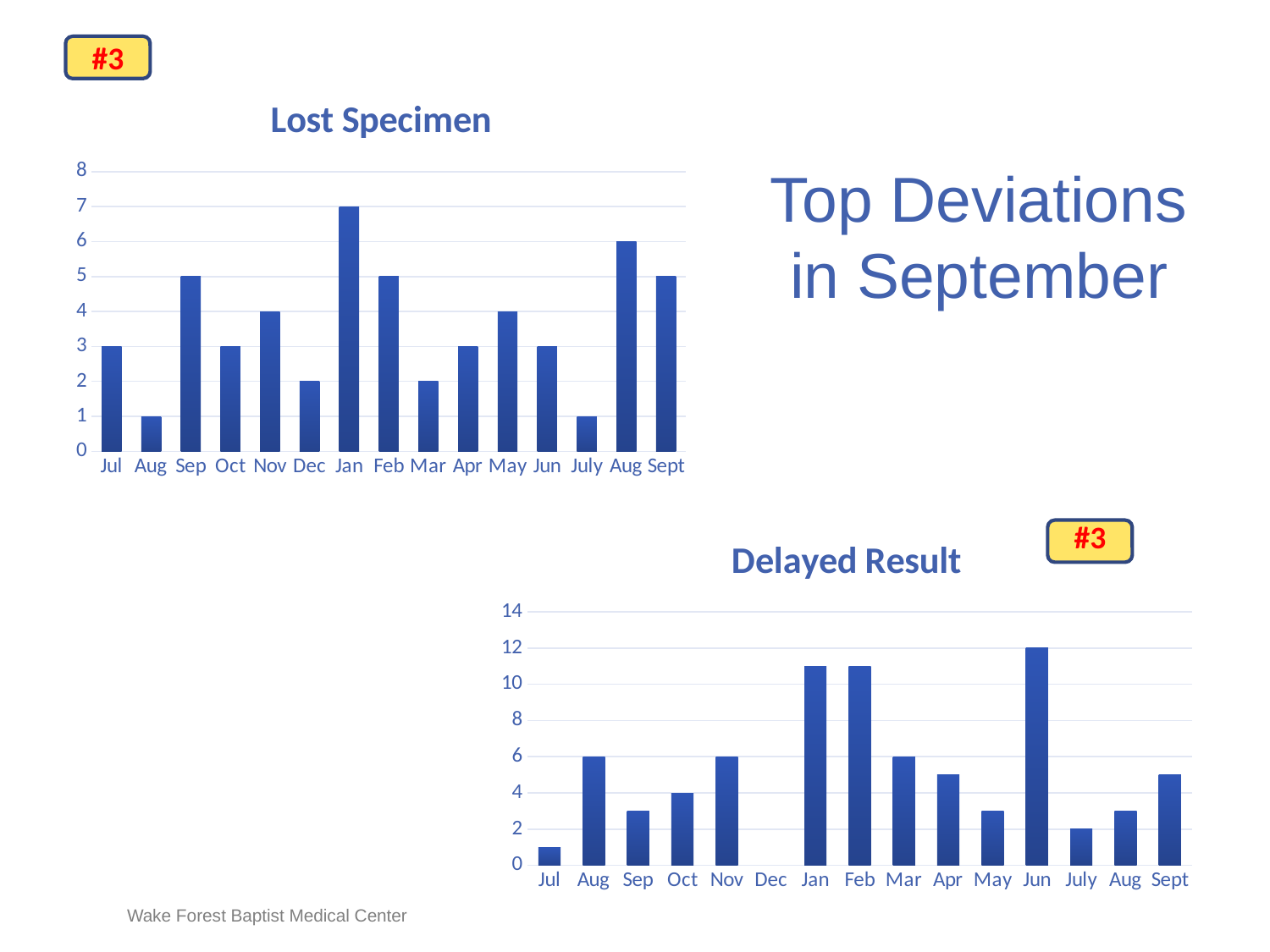
In the Lost Specimen chart, what is the value for Sep? 5 How many months are shown on the x axis of the Lost Specimen chart? 15 In the Delayed Result chart, what is the value for Jun? 12 What kind of chart is the Lost Specimen chart? Bar chart In the Delayed Result chart, is the value for Jan greater or less than 10? greater In the Lost Specimen chart, which is larger, the value for Nov or the value for Mar? Nov In the Lost Specimen chart, which month has the highest value? Jan In the Lost Specimen chart, what is the difference between the values for Jan and Dec? 5 In the Delayed Result chart, what is the value for Oct? 4 In the Delayed Result chart, which month has the highest value? Jun In the Lost Specimen chart, what is the value for Jan? 7